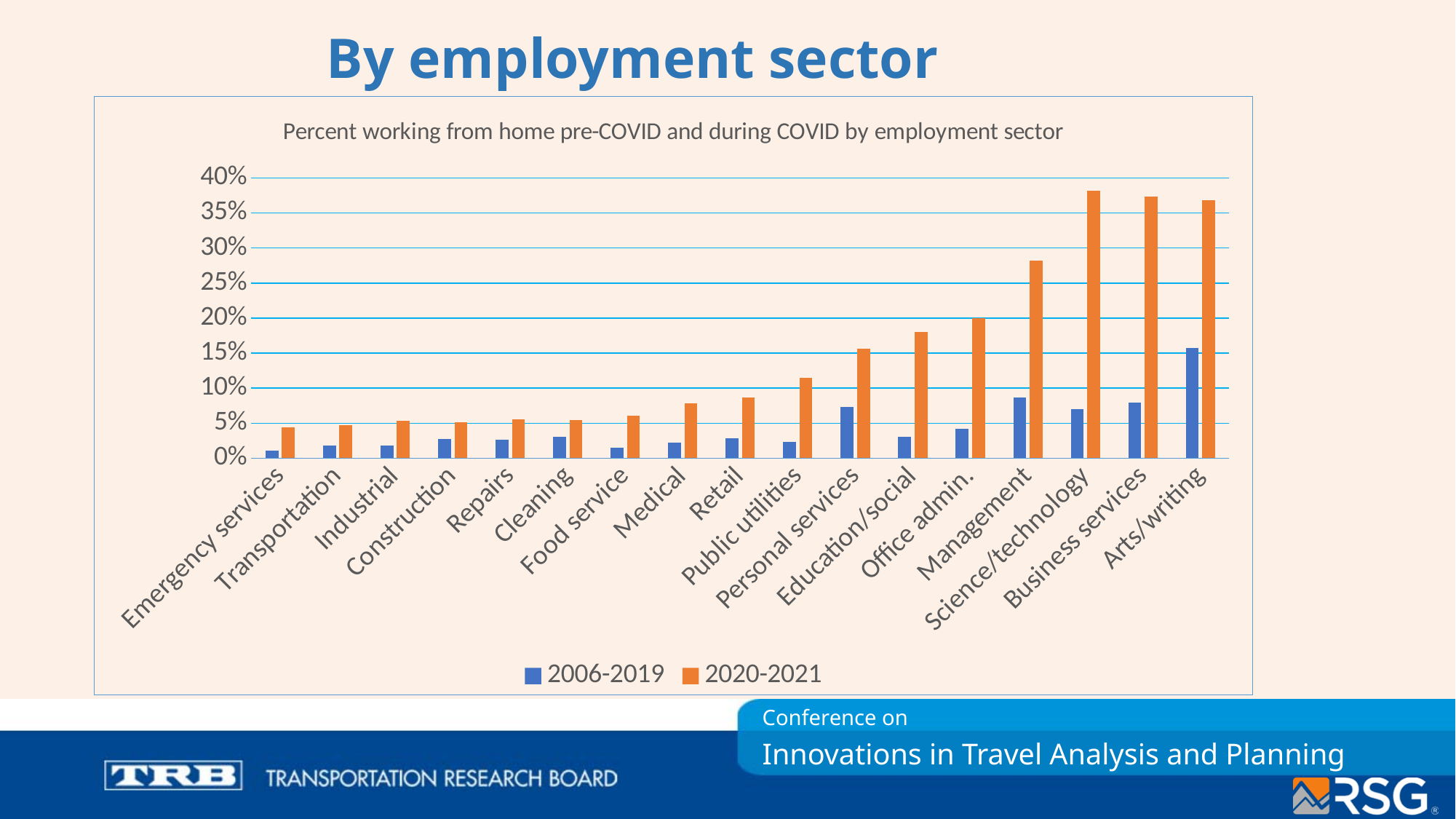
Is the 2020-2021 value for Emergency services greater or less than 5%? less Is the 2020-2021 value for Education/social greater or less than 20%? less Is the 2020-2021 value for Management greater or less than 25%? greater How many series does the chart's legend list? 2 What kind of chart is shown on the slide? bar chart How many employment sectors are shown on the x axis of the chart? 17 Which employment sector has the highest 2006-2019 value? Arts/writing Which is larger: the 2020-2021 value for Management or the 2020-2021 value for Office admin.? Management Which employment sector has the lowest 2006-2019 value? Emergency services Do the 2020-2021 values generally rise or fall moving left to right along the x axis? rise